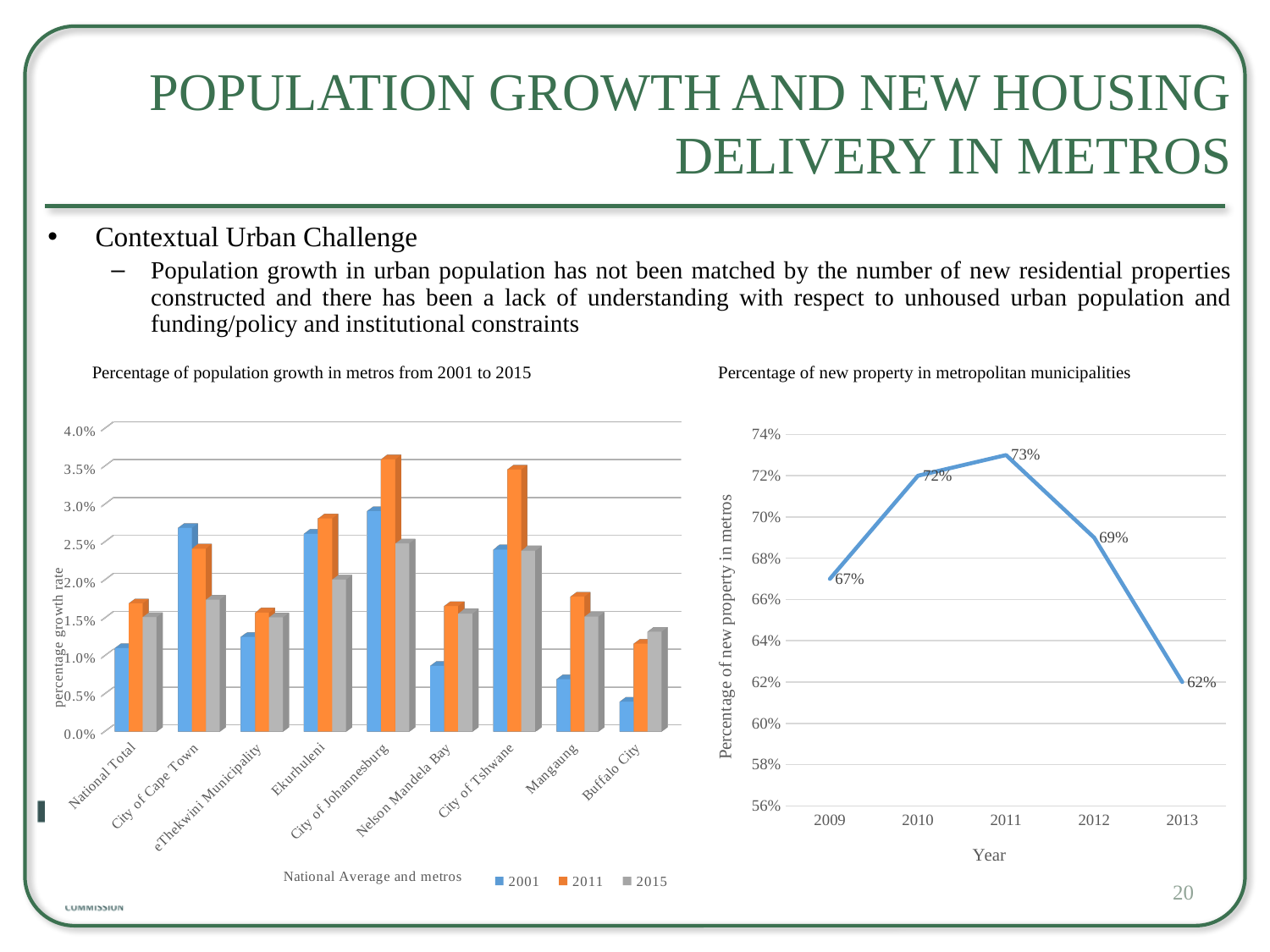
What kind of chart is the one titled 'Percentage of new property in metropolitan municipalities'? Line chart What kind of chart is the one titled 'Percentage of population growth in metros from 2001 to 2015'? Bar chart In the chart titled 'Percentage of new property in metropolitan municipalities', what is the value for 2009? 67% In the chart titled 'Percentage of new property in metropolitan municipalities', what is the value for 2011? 73% In the chart titled 'Percentage of population growth in metros from 2001 to 2015', how many series does the legend list? 3 In the chart titled 'Percentage of new property in metropolitan municipalities', which year has the lowest value? 2013 In the chart titled 'Percentage of population growth in metros from 2001 to 2015', how many categories are shown on the x axis? 9 In the chart titled 'Percentage of new property in metropolitan municipalities', do the values rise or fall from 2011 to 2013? Fall In the chart titled 'Percentage of new property in metropolitan municipalities', what is the difference between the 2011 value and the 2013 value? 11 percentage points In the chart titled 'Percentage of new property in metropolitan municipalities', which year has the highest value? 2011 In the chart titled 'Percentage of population growth in metros from 2001 to 2015', is the 2011 value for City of Johannesburg greater or less than 3.0%? greater In the chart titled 'Percentage of new property in metropolitan municipalities', how many years are plotted? 5